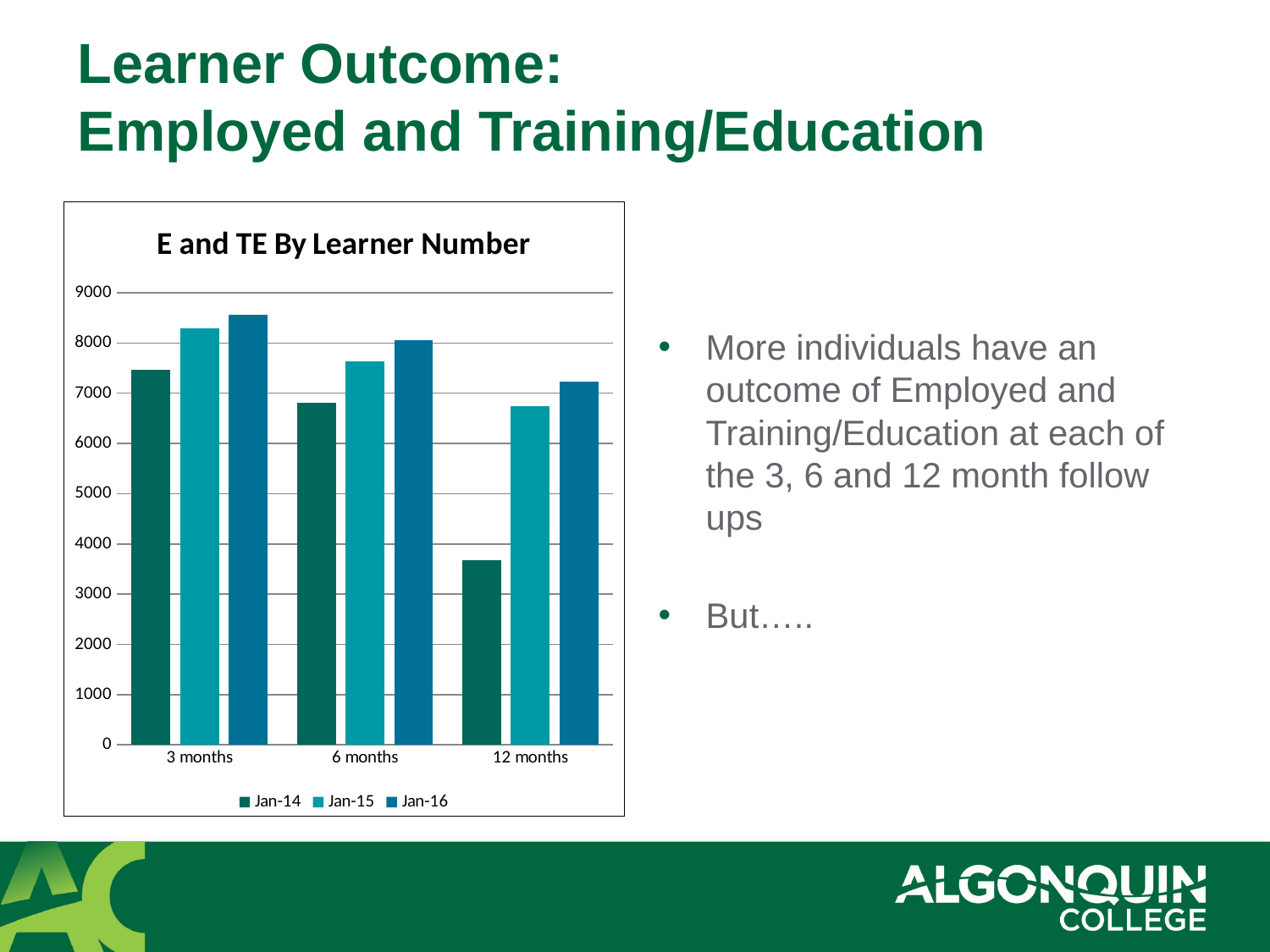
How many series does the legend list? 3 Do the Jan-14 values rise or fall from 3 months to 12 months? fall Which series has the lowest value at 3 months? Jan-14 Is the Jan-16 value at 3 months greater or less than 8000? greater What is the title of the chart? E and TE By Learner Number What kind of chart is shown on the slide? bar chart Is the Jan-15 value at 6 months greater or less than 7000? greater Is the Jan-14 value at 12 months greater or less than 4000? less How many categories are shown on the x axis? 3 Which is larger: the Jan-15 value at 3 months or the Jan-15 value at 12 months? Jan-15 at 3 months Which category has the lowest Jan-14 value? 12 months Which series has the highest value at 12 months? Jan-16